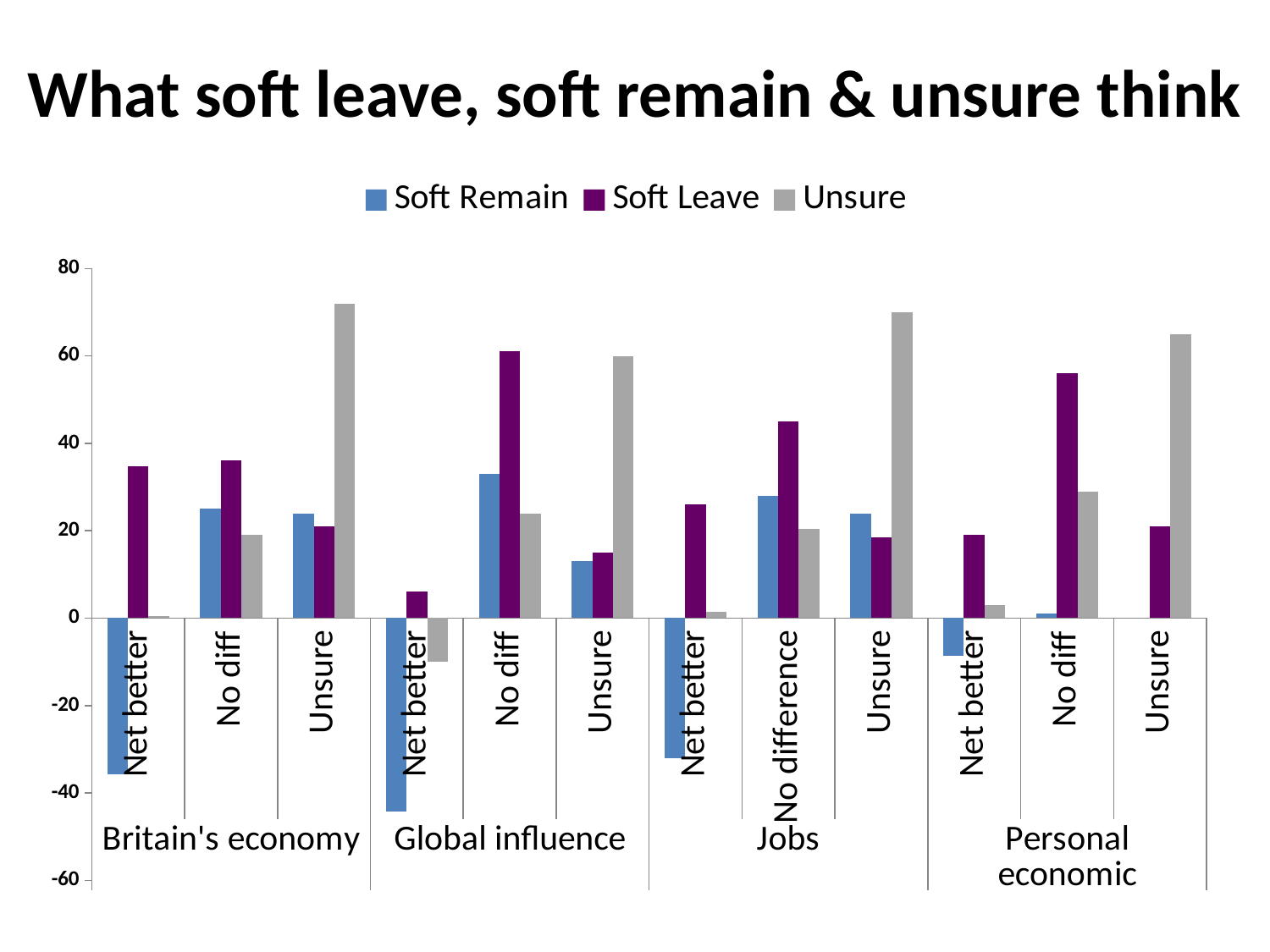
Which series has the tallest bar for 'No diff' under Global influence? Soft Leave Is the Soft Leave value for 'No difference' under Jobs greater or less than 40? greater Which is larger: the Soft Leave value for 'Net better' under Britain's economy or the Soft Leave value for 'Net better' under Personal economic? Britain's economy Is the Soft Remain value for 'Net better' under Global influence greater or less than -40? less What kind of chart is shown on the slide? bar chart What is the title of the slide? What soft leave, soft remain & unsure think Is the Unsure value for 'Net better' under Global influence greater or less than 0? less How many series does the legend list? 3 How many top-level topic groups are shown along the x axis? 4 Which bar on the chart has the lowest value overall? Soft Remain, Net better, Global influence What are the three series named in the legend? Soft Remain, Soft Leave, Unsure